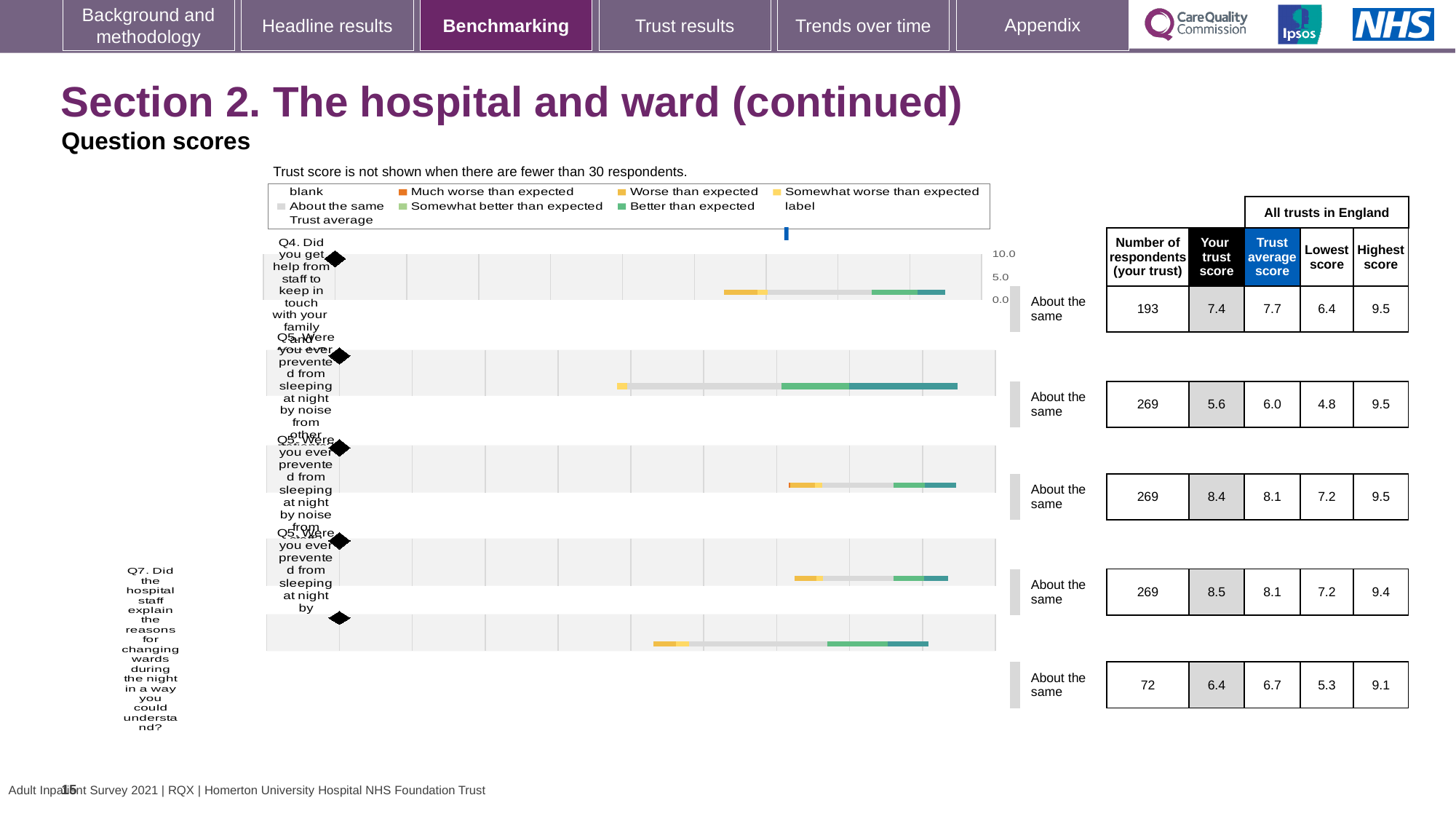
What is the 'Your trust score' for the last row, Q7 (Did the hospital staff explain the reasons for changing wards during the night)? 6.4 For Q4, which is larger: your trust score or the trust average score? Trust average score How many question rows are plotted in the chart? 5 What kind of chart is used to show the question scores on this slide? bar chart What is the difference between the highest and lowest scores for Q4? 3.1 What is the 'Your trust score' for Q4 (Did you get help from staff to keep in touch with your family)? 7.4 Which question row has the fewest respondents? Q7 (72 respondents) How many respondents answered Q4 at your trust? 193 What is the highest score across all trusts in England for Q4? 9.5 What is the trust average score for Q4? 7.7 What benchmark category is shown for Q4? About the same Which row has the highest 'Your trust score'? The fourth row (8.5)